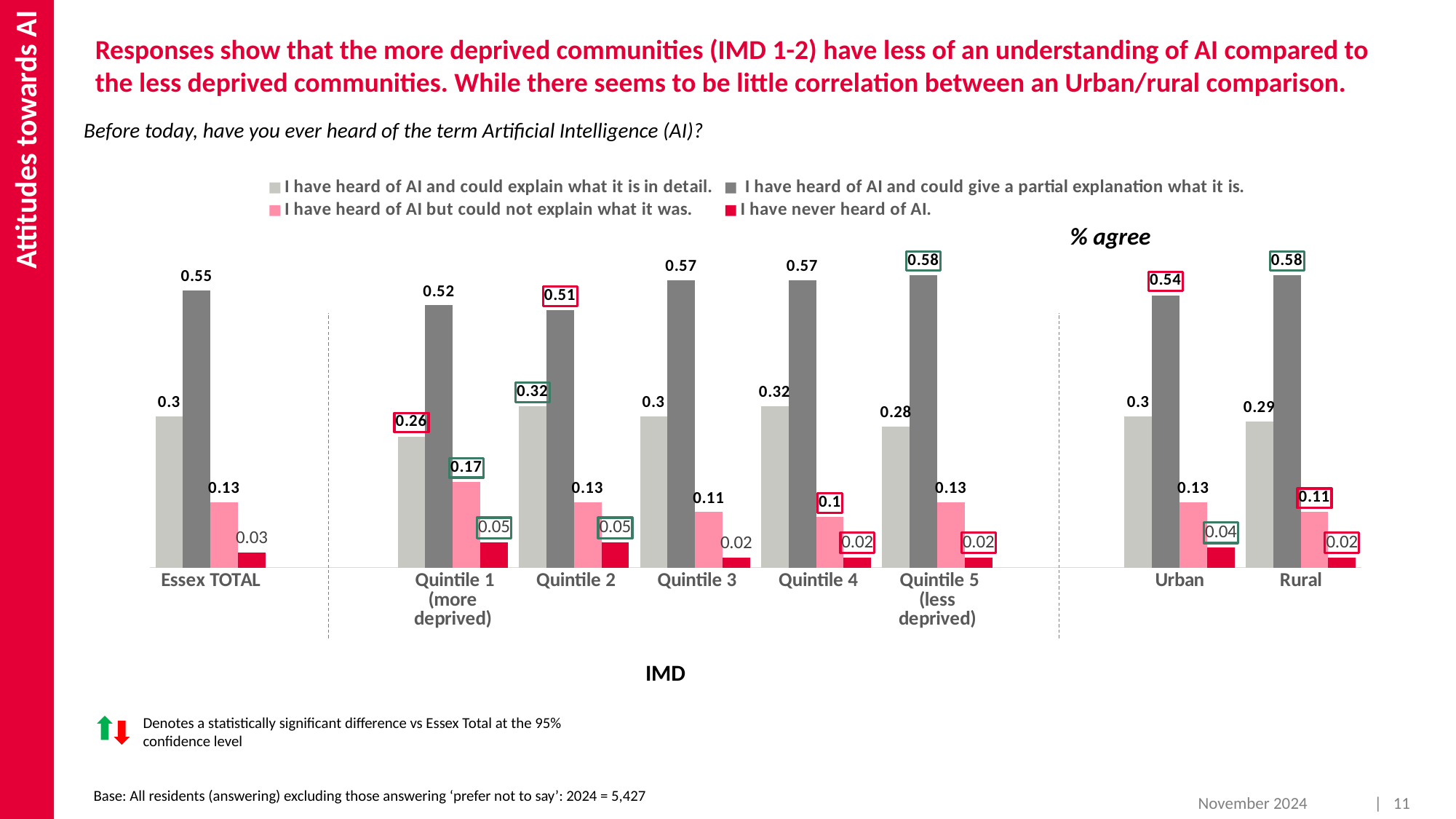
What is the value for 'I have heard of AI and could give a partial explanation what it is.' for Essex TOTAL? 0.55 What kind of chart is shown on the slide? Bar chart Which is larger: the 'I have heard of AI and could explain what it is in detail.' value for Quintile 4 or for Quintile 5 (less deprived)? Quintile 4 What is the total of the four values shown for Rural? 1 How many categories are shown on the x axis of the chart? 8 What is the value for 'I have never heard of AI.' for Urban? 0.04 Which category has the lowest value for 'I have heard of AI and could explain what it is in detail.'? Quintile 1 (more deprived) How many series does the legend list? 4 Which category has the highest value for 'I have heard of AI but could not explain what it was.'? Quintile 1 (more deprived) What is the value for 'I have heard of AI but could not explain what it was.' for Quintile 1 (more deprived)? 0.17 What is the difference between the 'I have heard of AI and could give a partial explanation what it is.' values for Rural and Urban? 0.04 What is the value for 'I have heard of AI and could explain what it is in detail.' for Quintile 2? 0.32